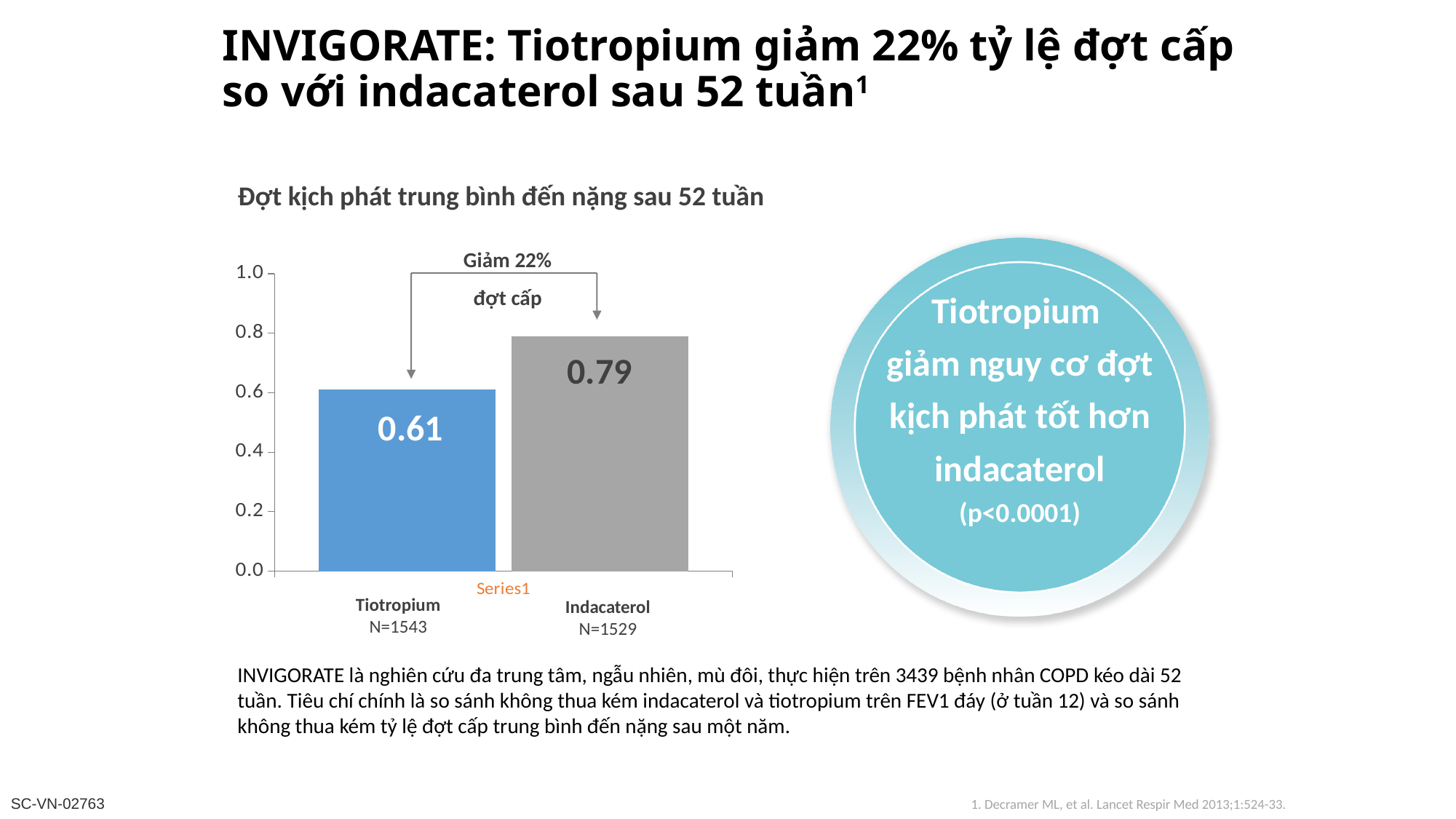
Which bar is higher, Tiotropium or Indacaterol? Indacaterol How many bars are shown in the chart? 2 What percentage reduction is annotated between the two bars? Giảm 22% What kind of chart is shown on the slide? bar chart What is the N value shown under the Tiotropium bar? N=1543 What is the value for Indacaterol? 0.79 Is the value for Tiotropium greater or less than 0.8? less What is the title of the chart? Đợt kịch phát trung bình đến nặng sau 52 tuần What is the value for Tiotropium? 0.61 Which bar is the lowest? Tiotropium Is the value for Indacaterol greater or less than 0.6? greater What is the difference between the Indacaterol and Tiotropium values? 0.18